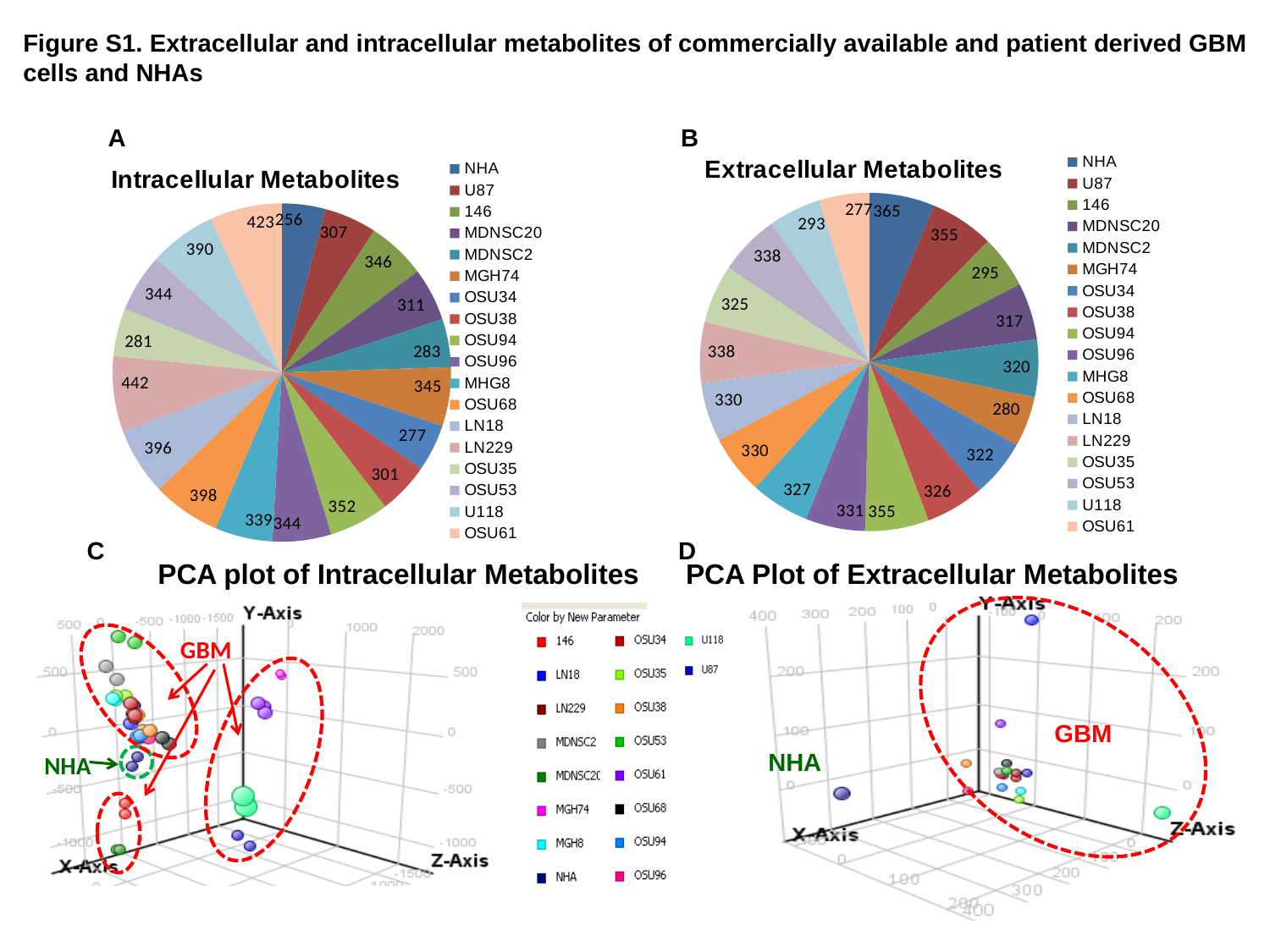
In the Intracellular Metabolites pie chart, what value is shown for OSU68? 398 What kind of chart is the Intracellular Metabolites chart (panel A)? Pie chart In the Intracellular Metabolites pie chart, which is larger, the value for OSU61 or the value for U87? OSU61 In the Extracellular Metabolites pie chart, what is the difference between the values for NHA and OSU61? 88 In the Extracellular Metabolites pie chart, what value is shown for MGH74? 280 In the Intracellular Metabolites pie chart, which category has the largest value? LN229 In the Extracellular Metabolites pie chart, which category has the smallest value? OSU61 How many categories does the legend of the Extracellular Metabolites pie chart list? 18 In the Intracellular Metabolites pie chart, what is the difference between the values for LN229 and NHA? 186 In the Intracellular Metabolites pie chart, which category has the smallest value? NHA In the Extracellular Metabolites pie chart, what value is shown for NHA? 365 In the Intracellular Metabolites pie chart, what value is shown for LN229? 442